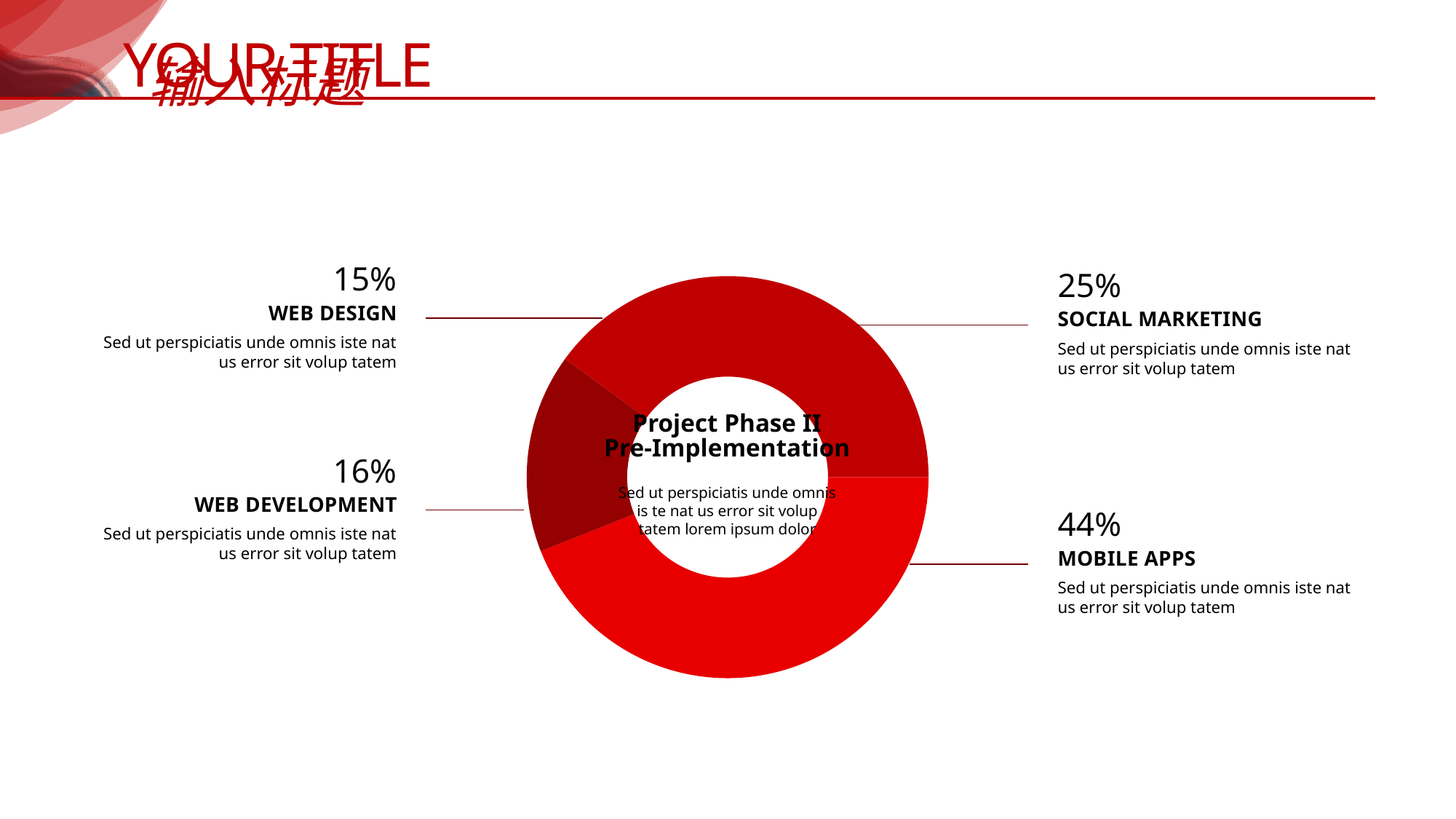
Which is larger, the share for Social Marketing or the share for Web Development? Social Marketing What text is written in the centre of the donut chart as its heading? Project Phase II Pre-Implementation What percentage is shown for Social Marketing? 25% What is the difference in percentage points between Mobile Apps and Social Marketing? 19 What percentage is shown for Mobile Apps? 44% Which category has the smallest share of the donut chart? Web Design What percentage is shown for Web Design? 15% How many categories are shown in the donut chart? 4 What is the difference in percentage points between Web Development and Web Design? 1 What percentage is shown for Web Development? 16% Which category has the largest share of the donut chart? Mobile Apps What kind of chart is shown on the slide? Donut chart